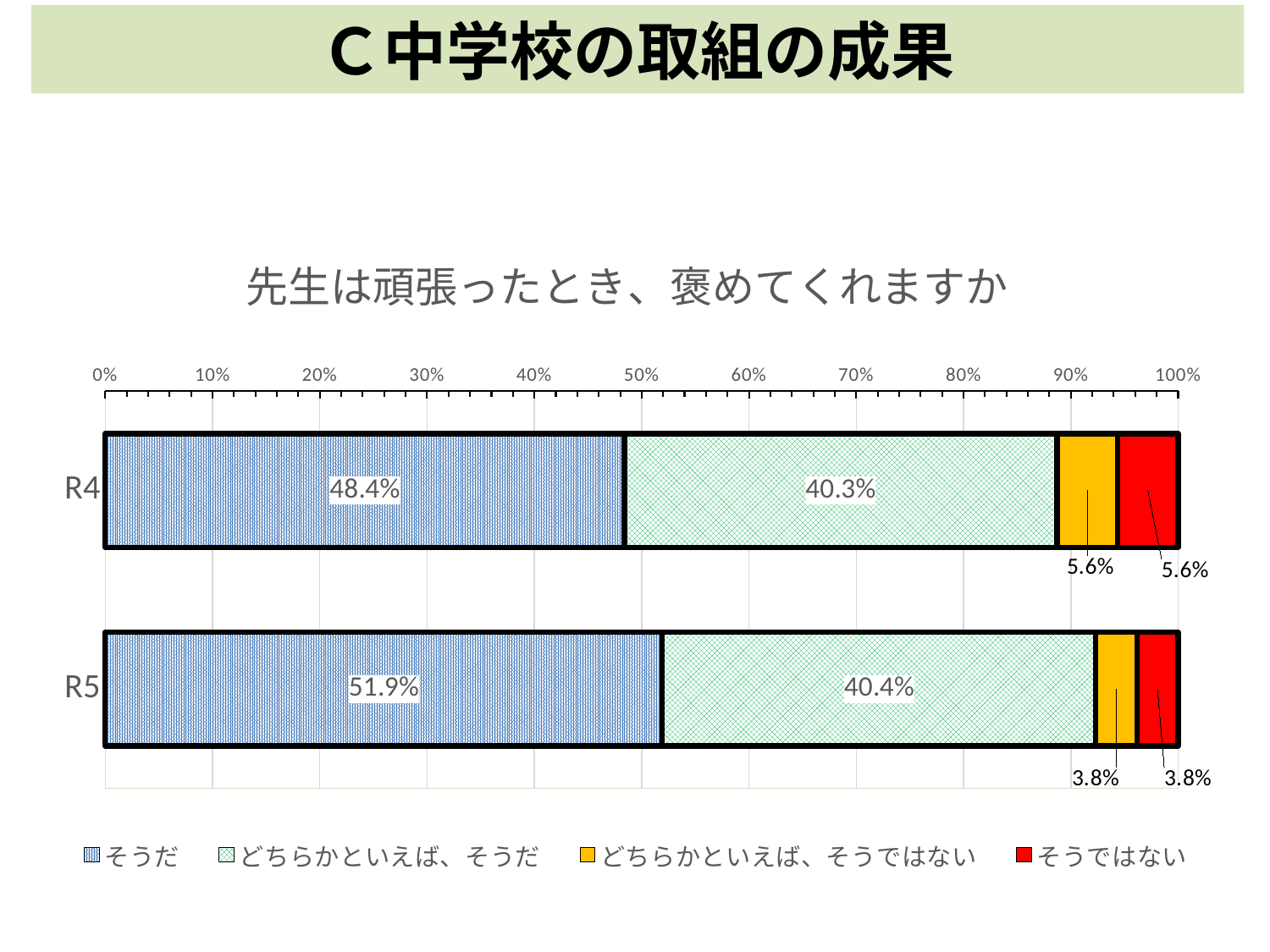
What is the difference between the そうだ values for R5 and R4? 3.5% Which year has the higher value for そうだ, R4 or R5? R5 What is the value of そうだ for R5? 51.9% What is the title of the chart? 先生は頑張ったとき、褒めてくれますか What is the value of そうではない for R5? 3.8% How many categories (years) are shown on the chart? 2 What is the value of どちらかといえば、そうだ for R4? 40.3% Which colour represents そうではない in the legend? Red What kind of chart is shown on the slide? Stacked bar chart What is the difference between the そうではない values for R4 and R5? 1.8% How many series does the legend list? 4 What is the value of どちらかといえば、そうではない for R4? 5.6%